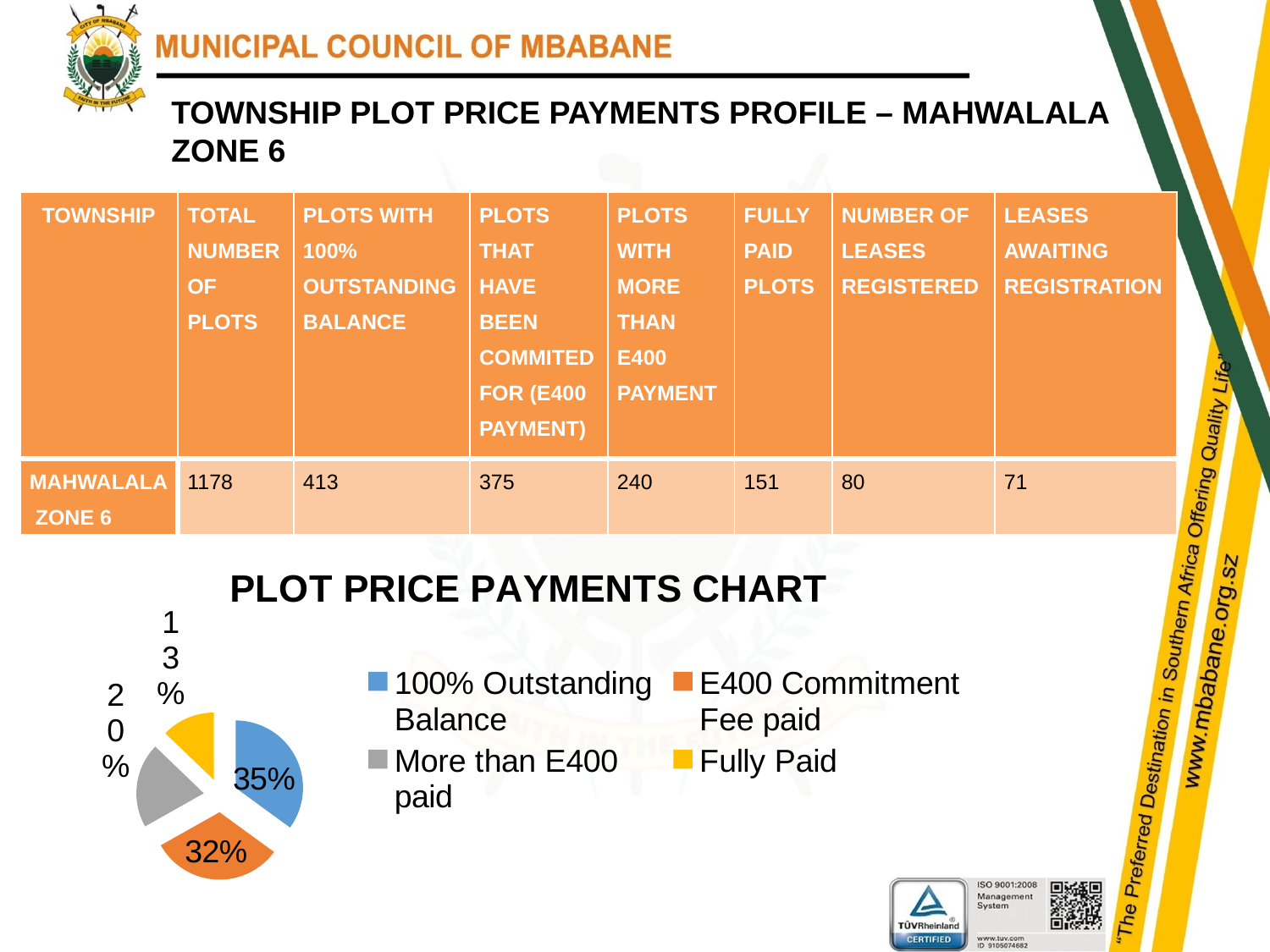
Which slice is larger: More than E400 paid or E400 Commitment Fee paid? E400 Commitment Fee paid How many entries does the legend of the PLOT PRICE PAYMENTS CHART list? 4 Which category has the smallest slice of the pie? Fully Paid What is the difference in percentage points between the 100% Outstanding Balance slice and the Fully Paid slice? 22 What colour is the Fully Paid slice in the pie chart? yellow What share of the pie is labelled for 100% Outstanding Balance? 35% What share of the pie is labelled for Fully Paid? 13% What share of the pie is labelled for More than E400 paid? 20% Which category has the largest slice of the pie? 100% Outstanding Balance How many slices does the PLOT PRICE PAYMENTS CHART pie have? 4 What kind of chart is the PLOT PRICE PAYMENTS CHART? pie chart What share of the pie is labelled for E400 Commitment Fee paid? 32%